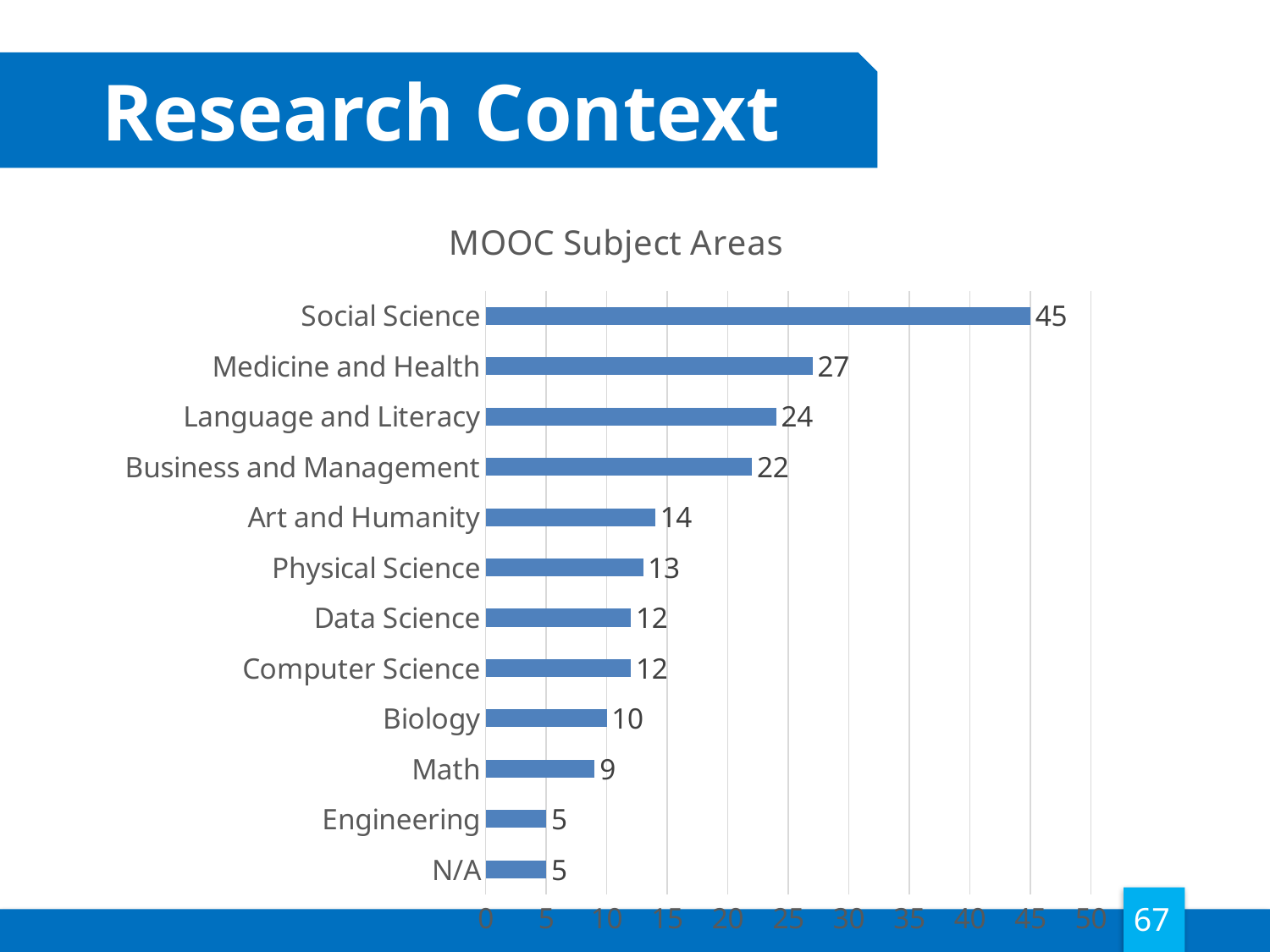
What kind of chart is shown on the slide? Bar chart What is the value for Engineering? 5 What is the title of the chart? MOOC Subject Areas Which subject area has the highest value? Social Science What is the difference between the values for Language and Literacy and Art and Humanity? 10 Is the value for Medicine and Health greater or less than 25? greater Which is larger, the value for Physical Science or the value for Math? Physical Science What is the value for Business and Management? 22 How many subject areas are shown in the chart? 12 What is the difference between the values for Social Science and Medicine and Health? 18 What is the value for Biology? 10 What is the value for Social Science in the MOOC Subject Areas chart? 45